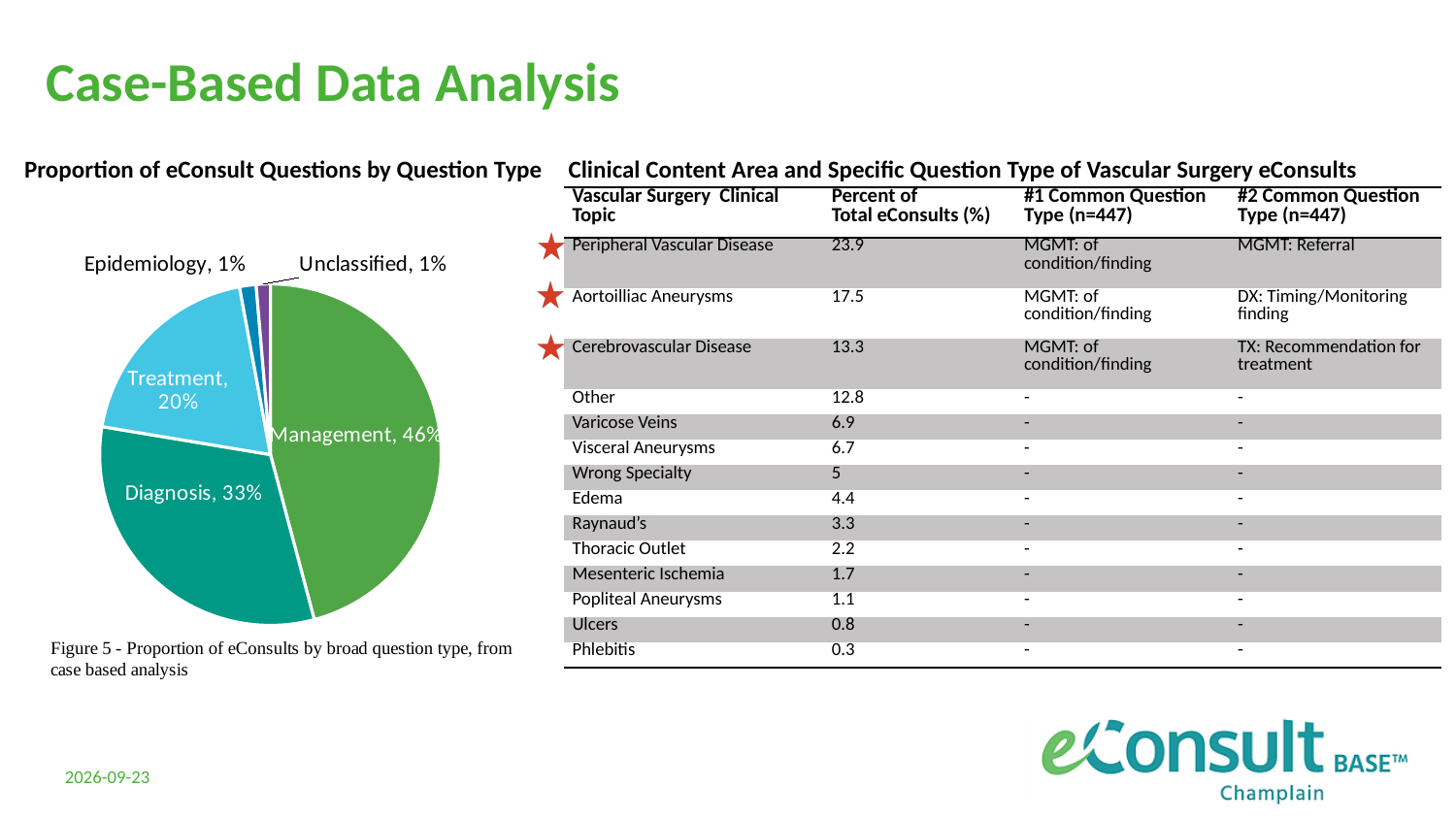
What kind of chart is shown on the slide? Pie chart What percentage of eConsult questions are Diagnosis questions? 33% What percentage of eConsult questions are Treatment questions? 20% What is the title of the pie chart? Proportion of eConsult Questions by Question Type Which question type has the largest share of the pie? Management What colour is the Management slice of the pie chart? Green What percentage of eConsult questions are Management questions? 46% What is the difference in percentage points between the Management and Diagnosis slices? 13 How many slices does the pie chart have? 5 Which is larger, the Diagnosis slice or the Treatment slice? Diagnosis What is the combined share of the Treatment and Diagnosis slices? 53% What percentage of eConsult questions are Epidemiology questions? 1%